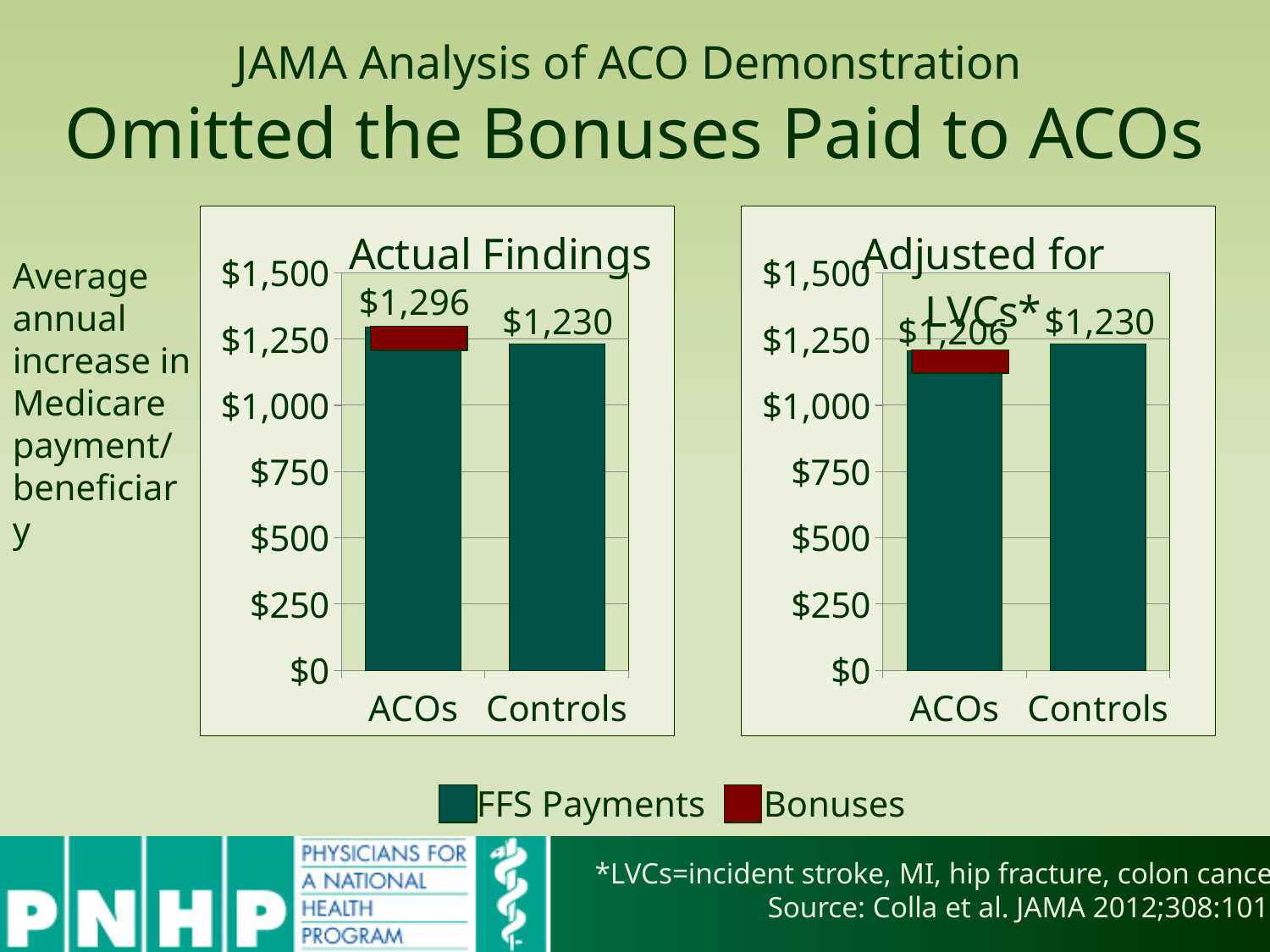
In the Adjusted for LVCs* chart, what is the total value shown for ACOs? $1,206 In the Actual Findings chart, what is the difference between the ACOs total and the Controls value? $66 What type of chart is the Actual Findings chart? Bar chart In the Actual Findings chart, what is the total value shown for ACOs? $1,296 In the Adjusted for LVCs* chart, which category has the higher total, ACOs or Controls? Controls In the Actual Findings chart, what is the value shown for Controls? $1,230 In the Adjusted for LVCs* chart, what is the difference between the Controls value and the ACOs total? $24 In the Actual Findings chart, which category has the higher total, ACOs or Controls? ACOs In the Adjusted for LVCs* chart, what is the value shown for Controls? $1,230 How many series does the shared legend list for the charts? 2 In the Actual Findings chart, is the total for ACOs greater or less than $1,250? greater How many categories are shown on the x axis of the Adjusted for LVCs* chart? 2